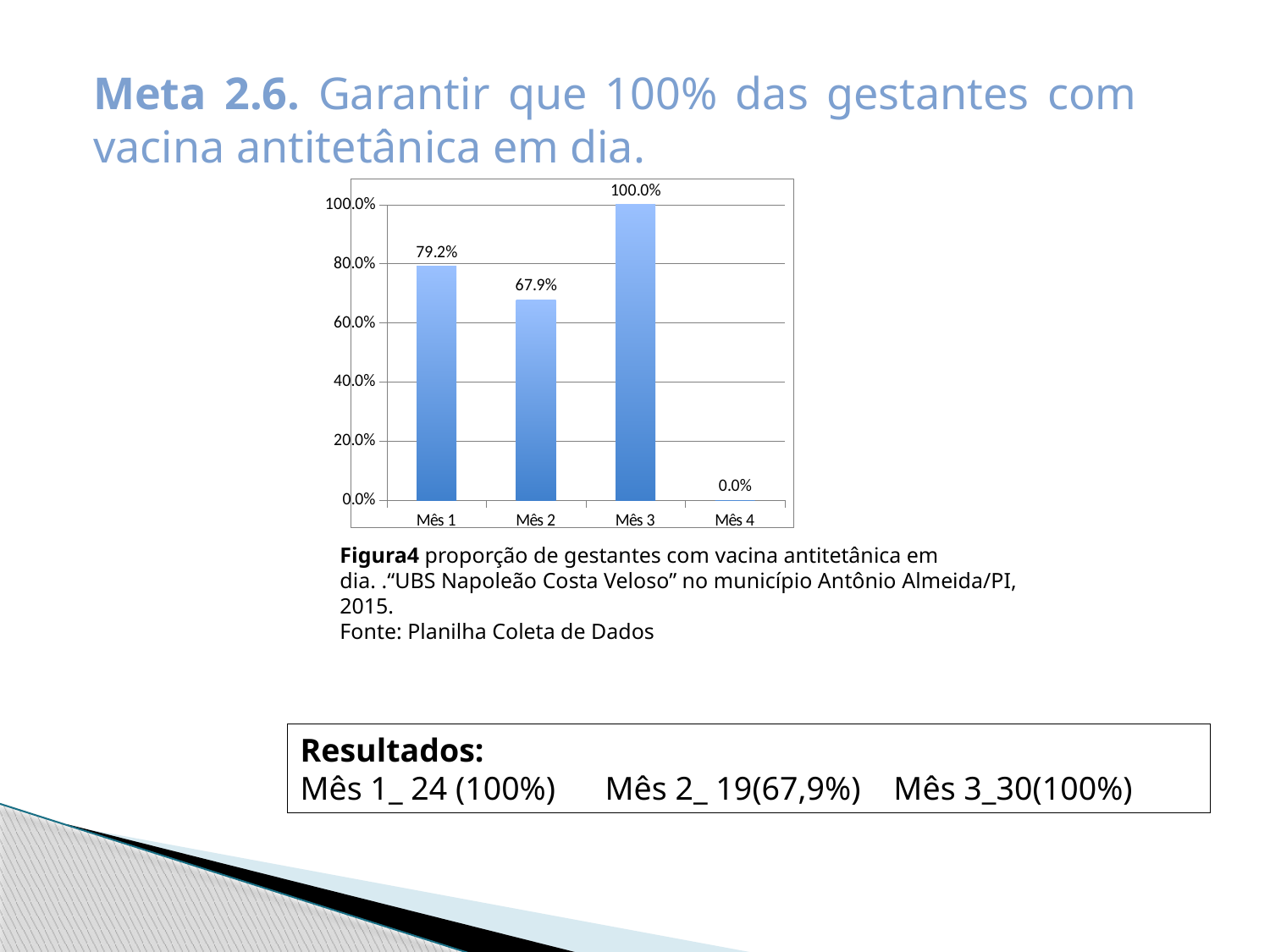
What is the value for Mês 3? 100.0% Which month has the lowest value? Mês 4 What is the difference between the values for Mês 1 and Mês 2? 11.3% What kind of chart is shown on the slide? Bar chart What is the value for Mês 1? 79.2% Which month has the highest value? Mês 3 Which is larger, the value for Mês 1 or the value for Mês 2? Mês 1 What is the value for Mês 4? 0.0% How many months are shown on the x axis? 4 Does the value rise or fall from Mês 1 to Mês 2? Fall What is the value for Mês 2? 67.9% What is the difference between the values for Mês 3 and Mês 2? 32.1%